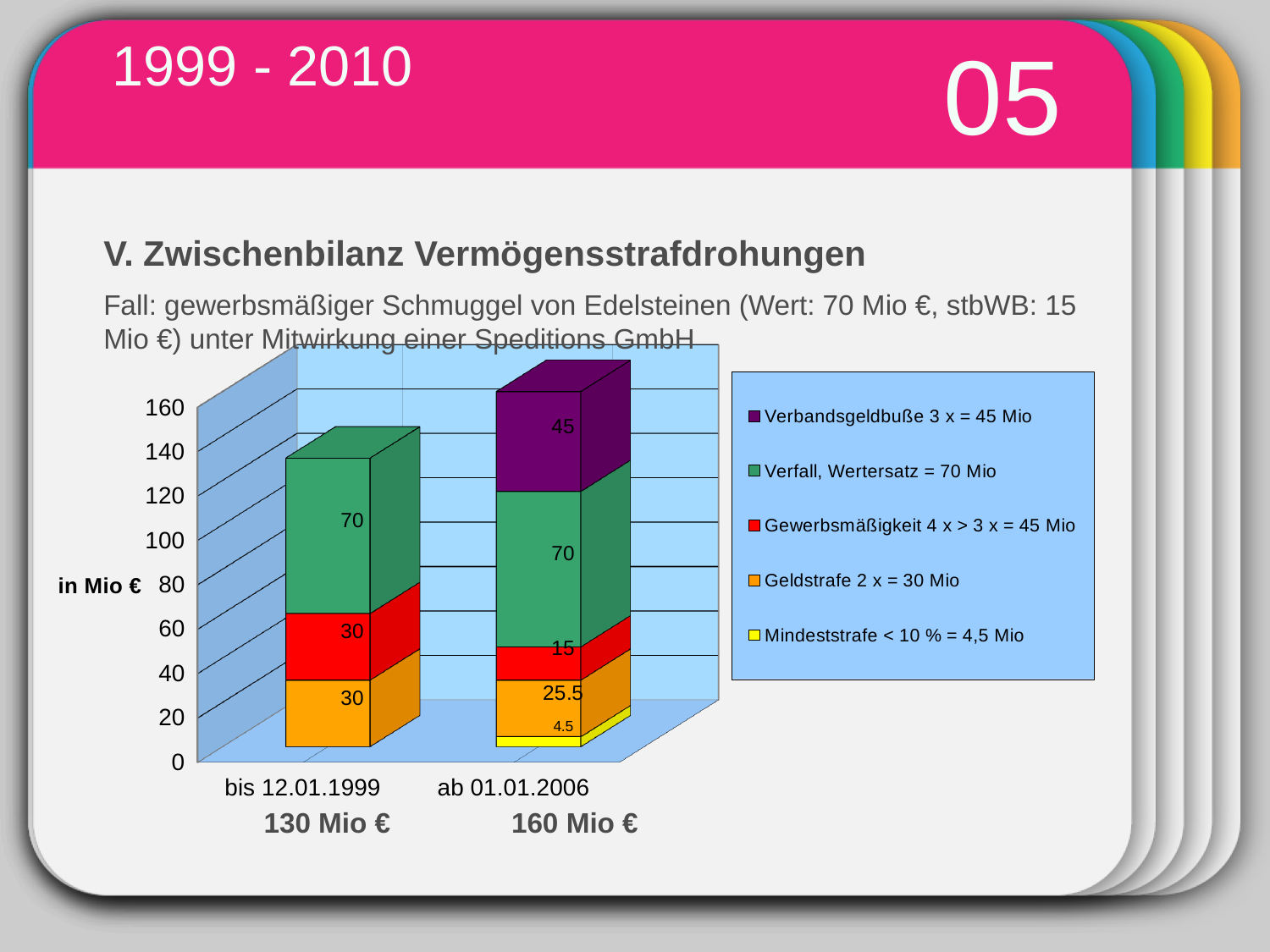
What is the total of the stacked bar for 'ab 01.01.2006'? 160 Mio € What is the value of the Mindeststrafe segment for 'ab 01.01.2006'? 4.5 What is the total of the stacked bar for 'bis 12.01.1999'? 130 Mio € How many categories are shown on the x axis of the chart? 2 What is the value of the Geldstrafe segment for 'bis 12.01.1999'? 30 What is the value of the Gewerbsmäßigkeit segment for 'ab 01.01.2006'? 15 How many series does the chart's legend list? 5 Which category has the higher total, 'bis 12.01.1999' or 'ab 01.01.2006'? ab 01.01.2006 What is the value of the Verbandsgeldbuße segment for 'ab 01.01.2006'? 45 What type of chart is shown on the slide? stacked bar chart What is the value of the Verfall, Wertersatz segment for 'ab 01.01.2006'? 70 What is the difference between the Geldstrafe values for 'bis 12.01.1999' (30) and 'ab 01.01.2006' (25.5)? 4.5